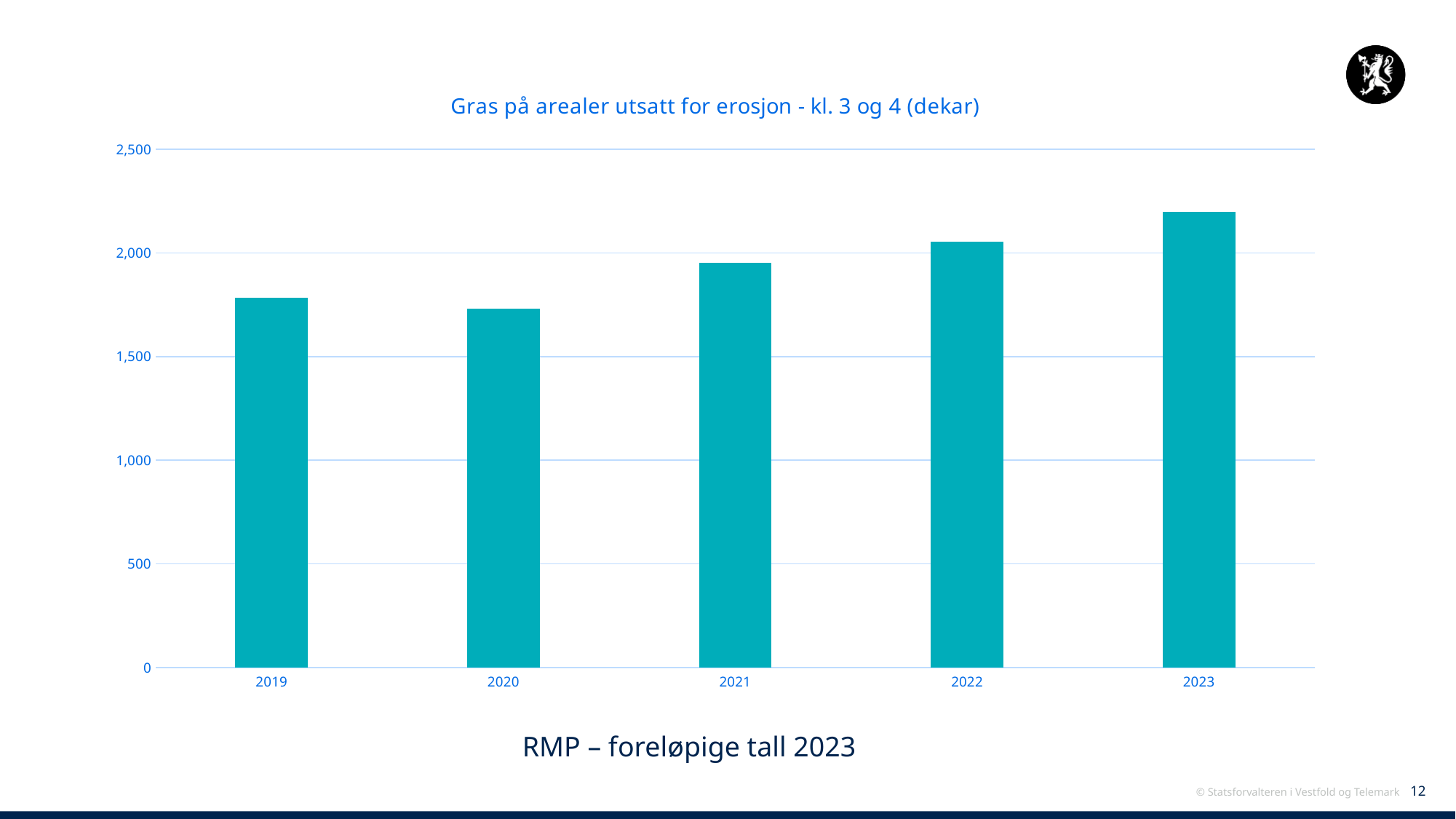
Which is larger, the value for 2023 or the value for 2019? 2023 Which year has the lowest value in the chart? 2020 How many years are shown on the x axis of the chart? 5 What is the highest value shown on the y axis of the chart? 2,500 What kind of chart is shown on the slide? bar chart Which year has the highest value in the chart? 2023 What is the title of the chart? Gras på arealer utsatt for erosjon - kl. 3 og 4 (dekar) Is the value for 2023 greater or less than 2,000? greater Do the values rise or fall from 2020 to 2023? rise Is the value for 2021 greater or less than 2,000? less Is the value for 2020 greater or less than 2,000? less